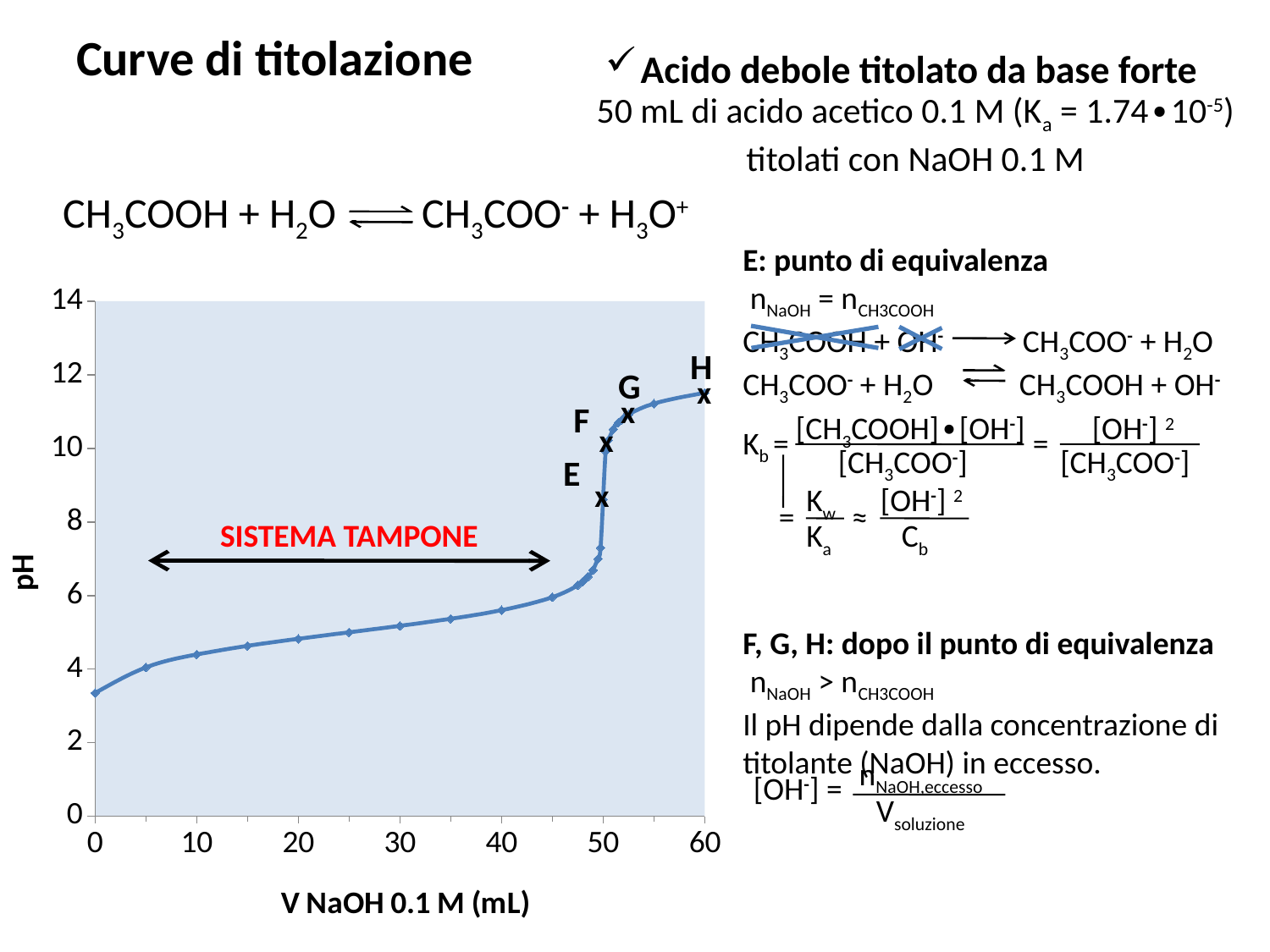
How many points on the curve are marked with letters (E, F, G, H)? 4 What is the label of the y axis of the chart? pH Does the pH rise or fall as the volume of NaOH increases along the x axis? rise At which volume of NaOH on the x axis is the pH highest? 60 Which is larger, the pH at 60 mL of NaOH or the pH at 0 mL of NaOH? 60 mL What kind of chart is shown on the slide? line chart Is the pH at 0 mL of NaOH greater or less than 4? less Is the pH at point E greater or less than 8? greater Is the pH at 60 mL of NaOH greater or less than 10? greater What is the label of the x axis of the chart? V NaOH 0.1 M (mL)